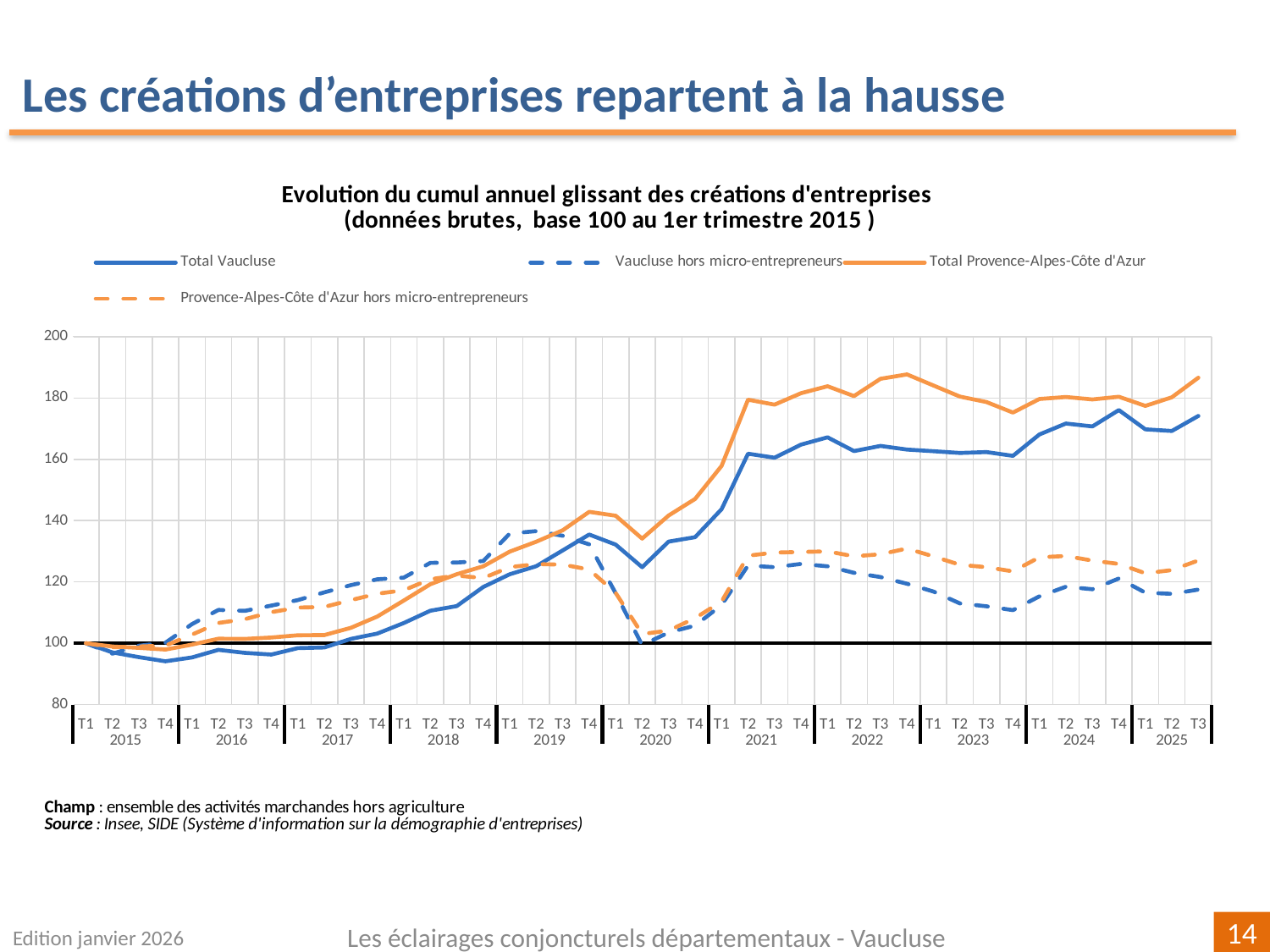
Is the value for Total Vaucluse at T3 2025 greater or less than 160? greater Is the value for Total Provence-Alpes-Côte d'Azur at T4 2022 greater or less than 180? greater What is the title of the chart? Evolution du cumul annuel glissant des créations d'entreprises (données brutes, base 100 au 1er trimestre 2015 ) Which series has the lowest value at T3 2025? Vaucluse hors micro-entrepreneurs Which series has the highest value at T3 2025? Total Provence-Alpes-Côte d'Azur How many series does the legend list? 4 What kind of chart is shown on the slide? line chart Is the value for Vaucluse hors micro-entrepreneurs at T3 2025 greater or less than 140? less What is the value of all series at T1 2015? 100 Overall, does the Total Vaucluse series rise or fall from T1 2015 to T3 2025? rise At T3 2025, which is higher: Total Provence-Alpes-Côte d'Azur or Total Vaucluse? Total Provence-Alpes-Côte d'Azur